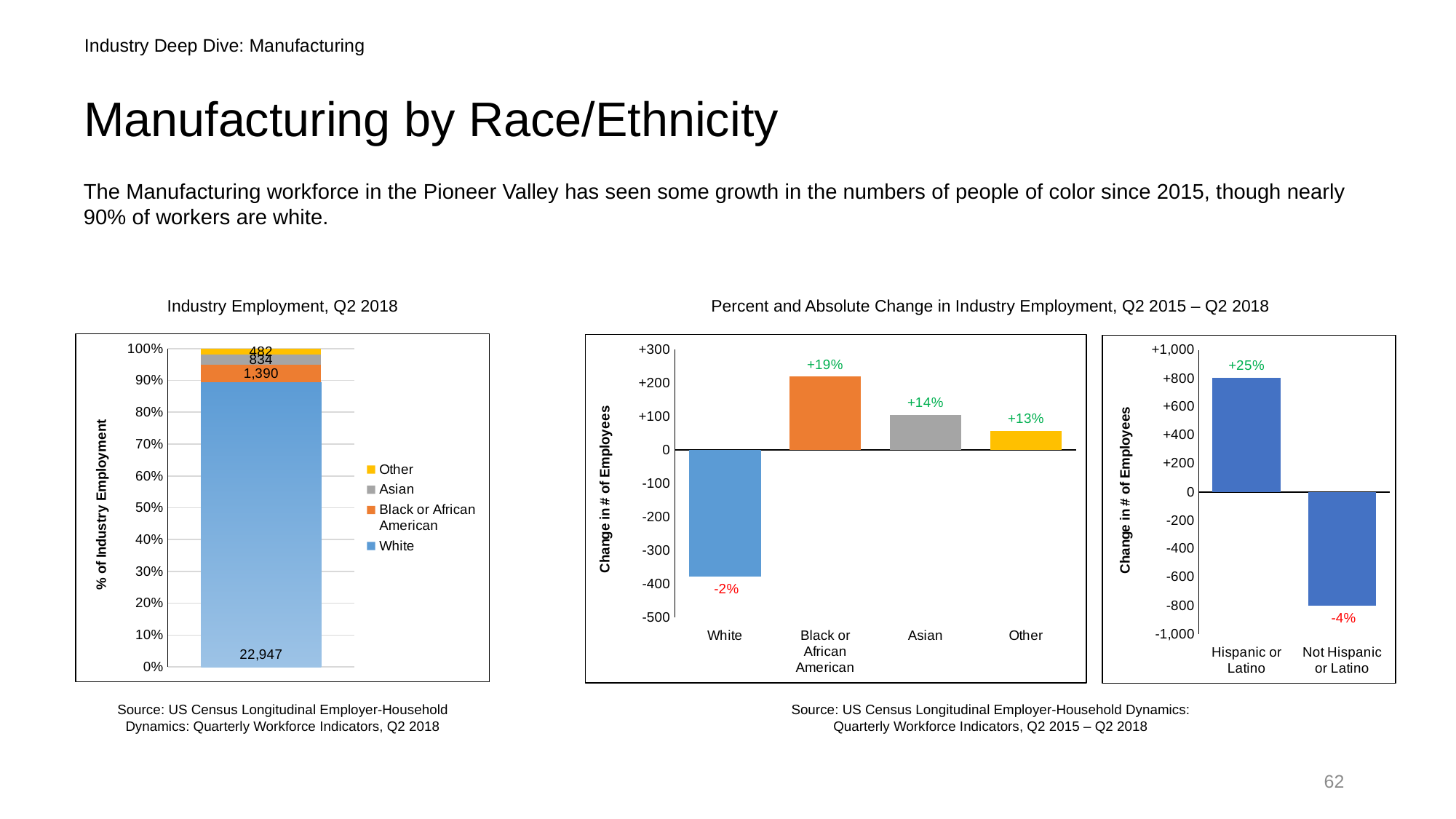
In the middle chart showing change in employment by race, how many categories are shown on the x axis? 4 In the Industry Employment, Q2 2018 chart, what is the difference between the Asian and Other values? 352 How many series does the legend of the Industry Employment, Q2 2018 chart list? 4 In the right chart showing change in employment by Hispanic or Latino status, what is the percent change labelled for Not Hispanic or Latino? -4% In the middle chart showing change in employment by race, which category has the lowest change in number of employees? White In the Industry Employment, Q2 2018 chart, what is the total of the stacked bar across all four groups? 25,653 What kind of chart is the right chart showing change in employment by Hispanic or Latino status? bar chart In the middle chart showing change in employment by race, is the change in number of employees for Other greater or less than +100? less In the middle chart showing change in employment by race, what is the percent change labelled for Black or African American? +19% In the Industry Employment, Q2 2018 chart, what is the value shown for White? 22,947 In the Industry Employment, Q2 2018 chart, what is the value shown for Black or African American? 1,390 In the middle chart showing change in employment by race, is the change in number of employees for White greater or less than -300? less